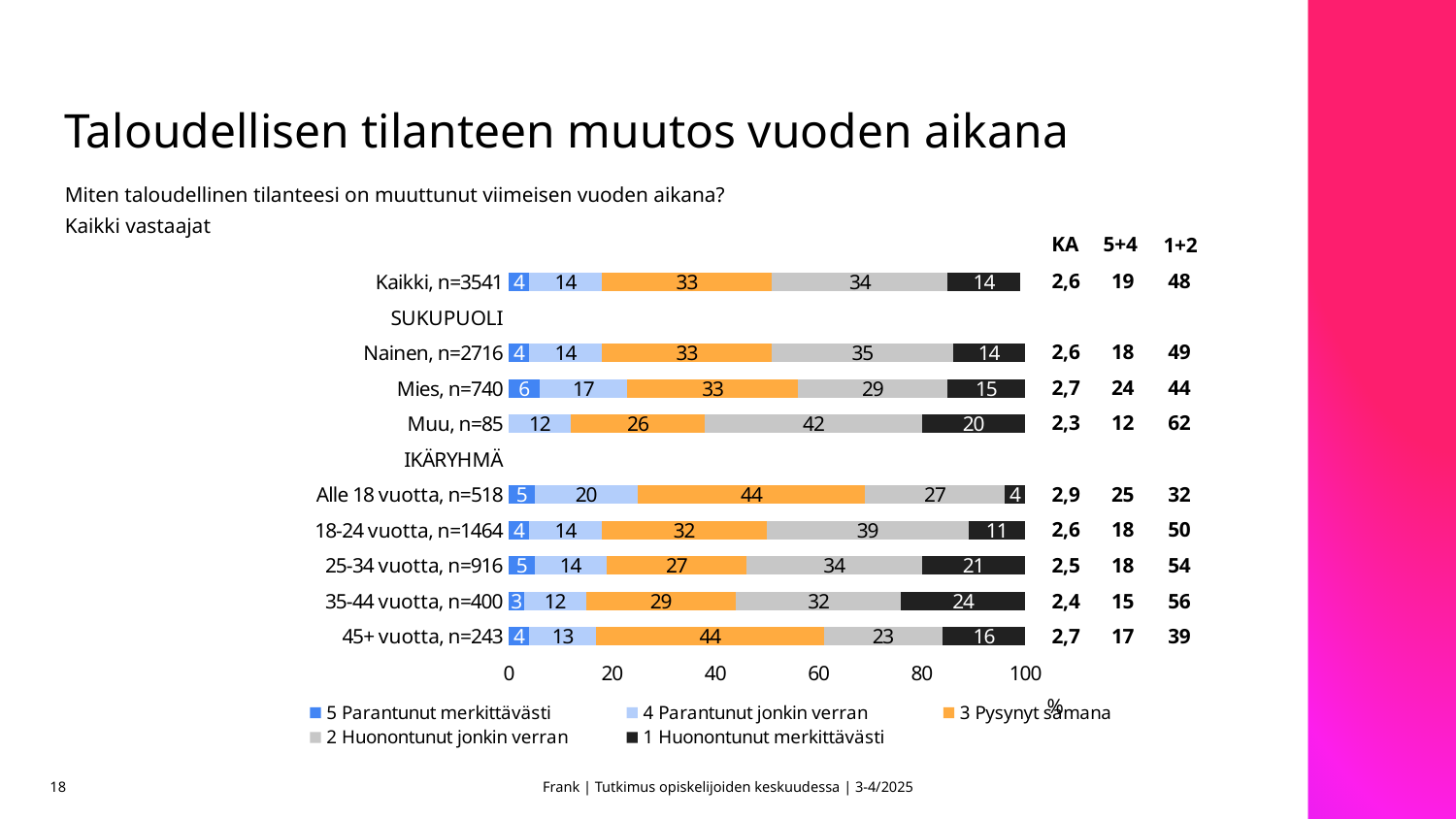
How many series does the legend list? 5 Which group has the lowest value for "1 Huonontunut merkittävästi"? Alle 18 vuotta, n=518 What is the value of "3 Pysynyt samana" for Kaikki, n=3541? 33 What is the value of "4 Parantunut jonkin verran" for Alle 18 vuotta, n=518? 20 Which group has the highest value for "1 Huonontunut merkittävästi"? 35-44 vuotta, n=400 What is the KA value shown for Alle 18 vuotta, n=518? 2,9 What is the value of "1 Huonontunut merkittävästi" for 35-44 vuotta, n=400? 24 What is the value of "2 Huonontunut jonkin verran" for Muu, n=85? 42 What type of chart is shown on the slide? Stacked bar chart What is the 1+2 value shown for Muu, n=85? 62 Which is larger: the "2 Huonontunut jonkin verran" value for Mies, n=740 or for Nainen, n=2716? Nainen, n=2716 What is the difference between the "3 Pysynyt samana" values for 45+ vuotta, n=243 and 25-34 vuotta, n=916? 17